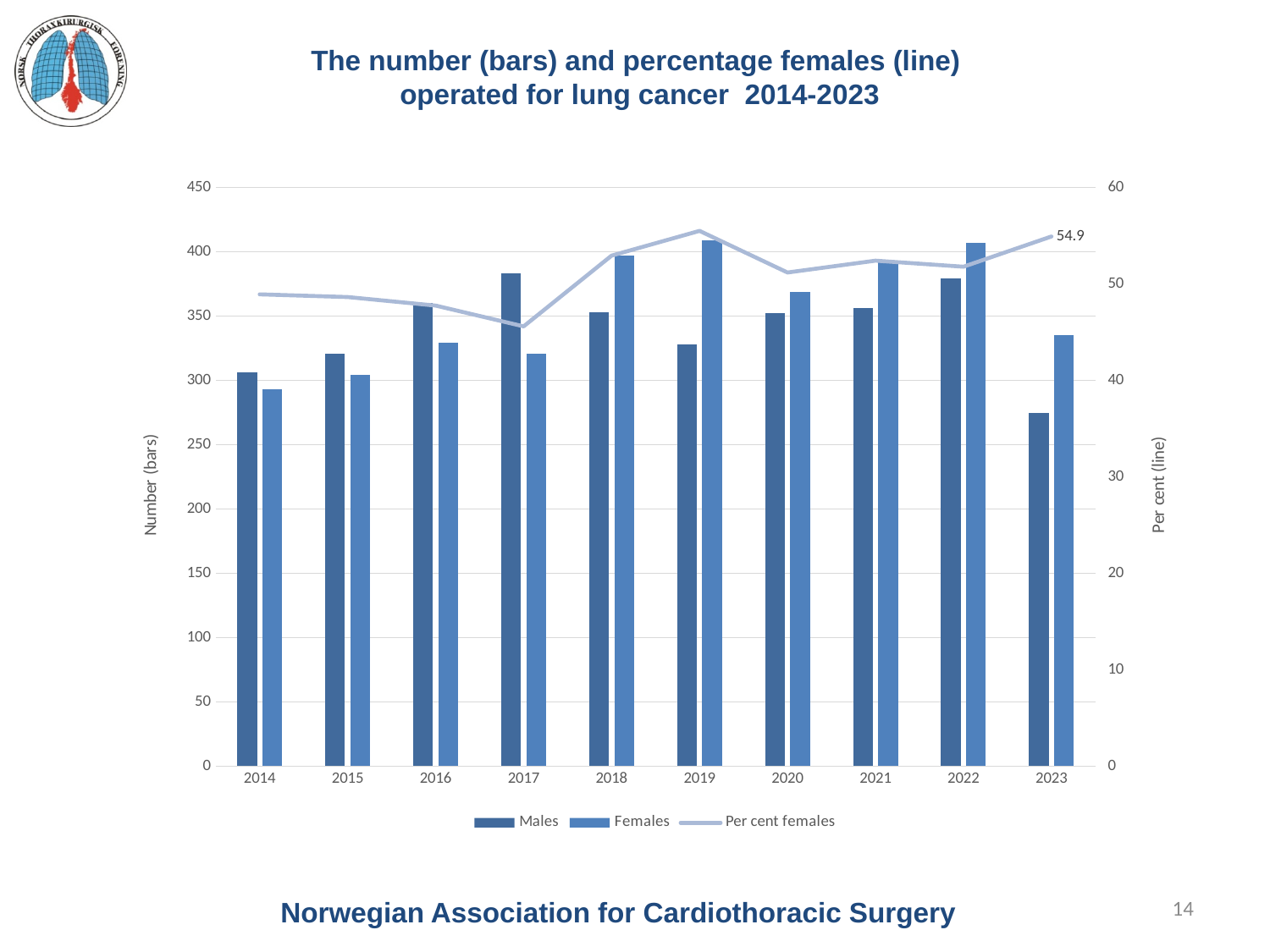
How many years are shown on the x axis? 10 Does the Per cent females line rise or fall from 2017 to 2019? rises How many series does the legend list? 3 What is the percentage of females operated for lung cancer in 2023, as labelled on the line? 54.9 Is the Males value for 2017 greater or less than 350? greater Which year has the lowest Females bar? 2014 Is the Females value for 2019 greater or less than 400? greater Is the Males value for 2023 greater or less than 300? less What kind of chart is shown on the slide? A bar chart combined with a line chart What is the title of the right-hand vertical axis? Per cent (line) Which year has the lowest Males bar? 2023 In 2014, which is larger, the Males bar or the Females bar? Males